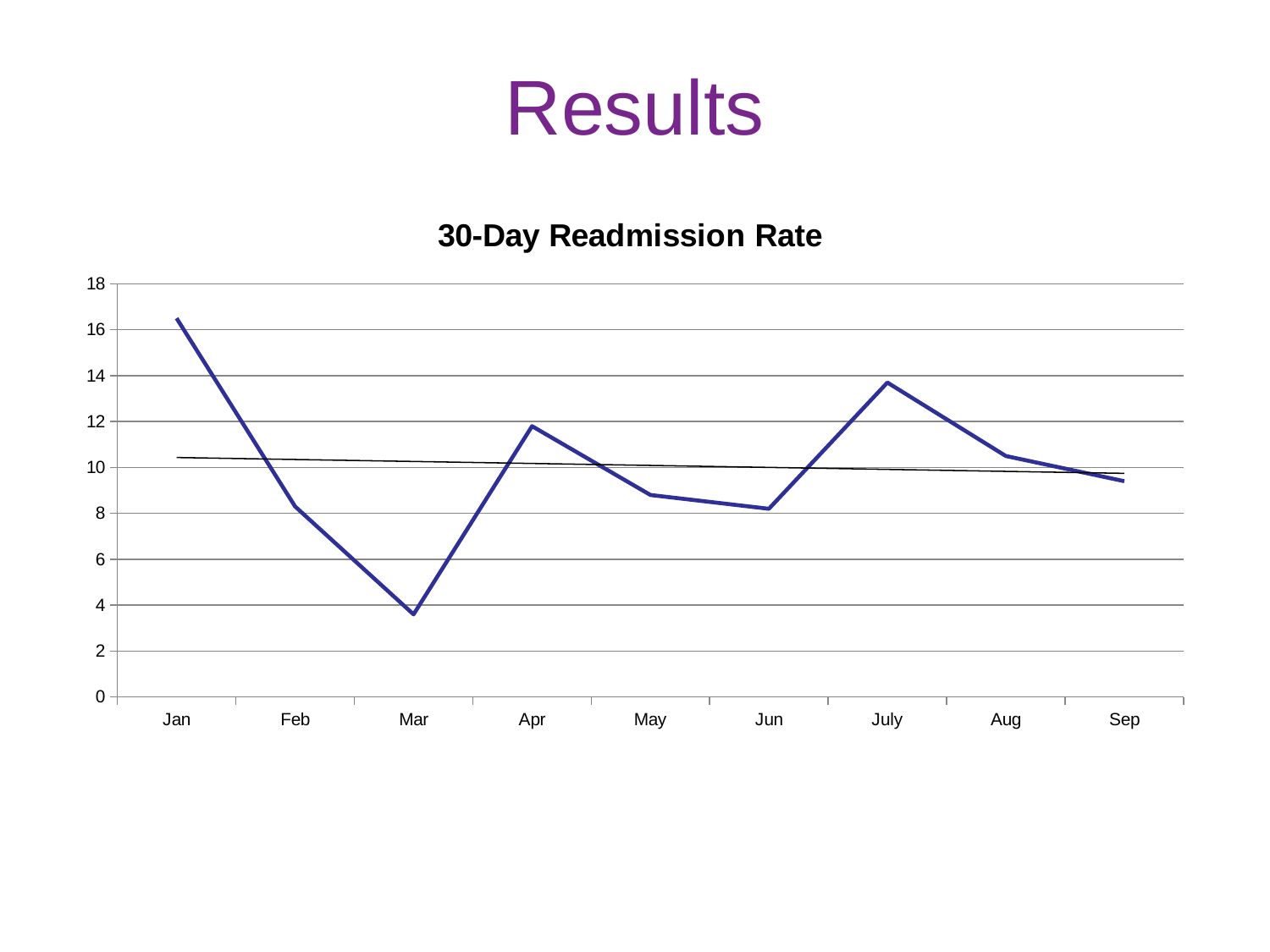
Which month has a higher readmission rate, Apr or May? Apr Which month has a higher readmission rate, Jan or July? Jan Does the thin black trend line rise or fall from Jan to Sep? fall Is the value for Jun greater or less than 10? less Is the value for Mar greater or less than 4? less Which month has the highest 30-day readmission rate? Jan What kind of chart is shown on the slide? line chart Is the value for July greater or less than 12? greater How many months are plotted along the x axis? 9 Which month has the lowest 30-day readmission rate? Mar What is the title of the chart? 30-Day Readmission Rate